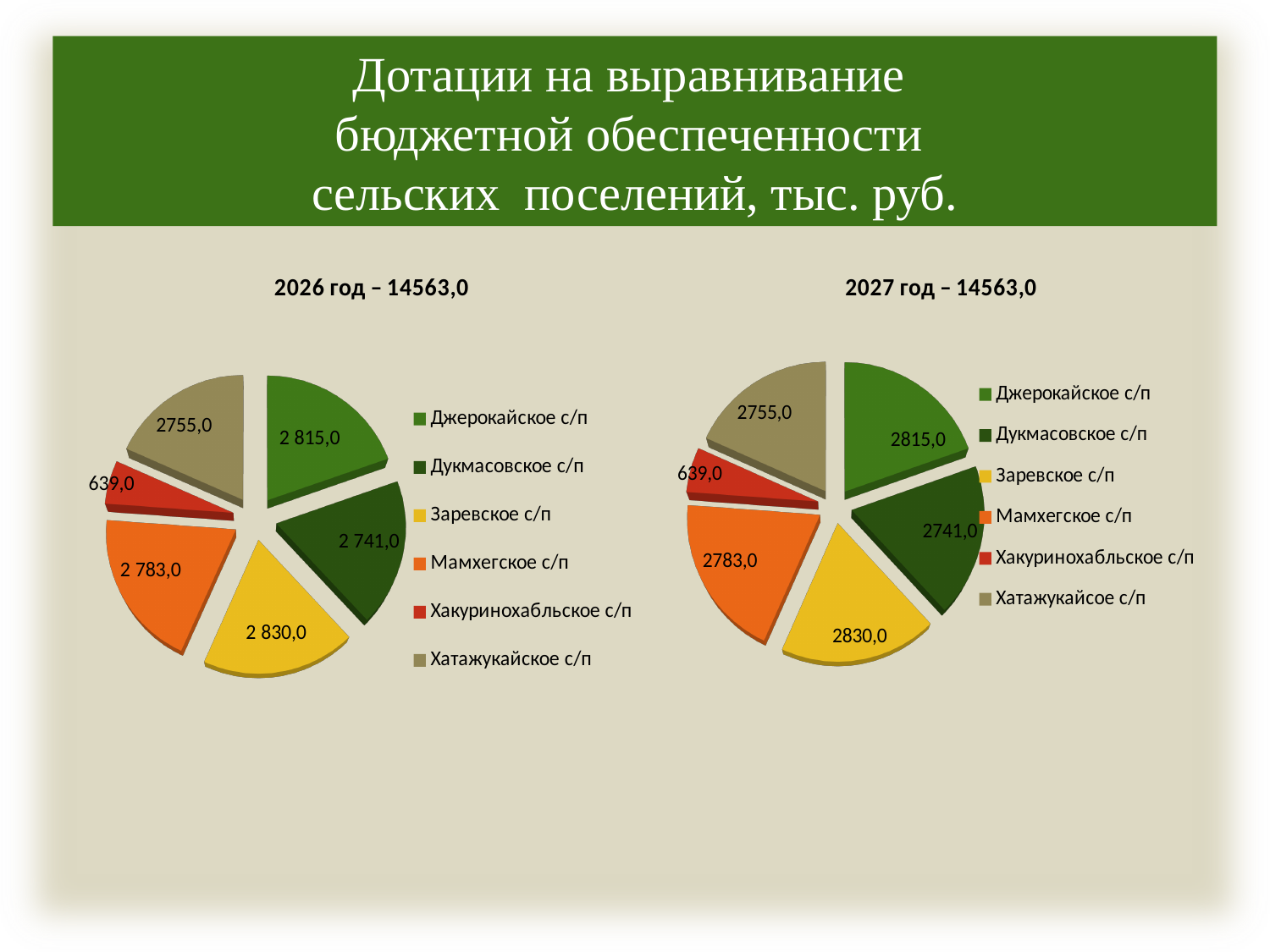
How many slices does the 2026 pie chart have? 6 In the 2026 chart, what is the value for Джерокайское с/п? 2 815,0 In the 2027 chart, what is the value for Мамхегское с/п? 2783,0 In the 2027 chart, which settlement has the largest value? Заревское с/п What total is shown in the heading above the 2026 chart? 14563,0 In the 2026 chart, what is the value for Хакуринохабльское с/п? 639,0 In the 2027 chart legend, which colour represents Заревское с/п? Yellow What type of chart is used for the 2027 data? Pie chart In the 2026 chart, what is the difference between the values for Заревское с/п and Джерокайское с/п? 15,0 In the 2027 chart, which is larger: Мамхегское с/п or Дукмасовское с/п? Мамхегское с/п In the 2027 chart, what is the value for Хатажукайсое с/п? 2755,0 In the 2026 chart, which settlement has the smallest slice? Хакуринохабльское с/п